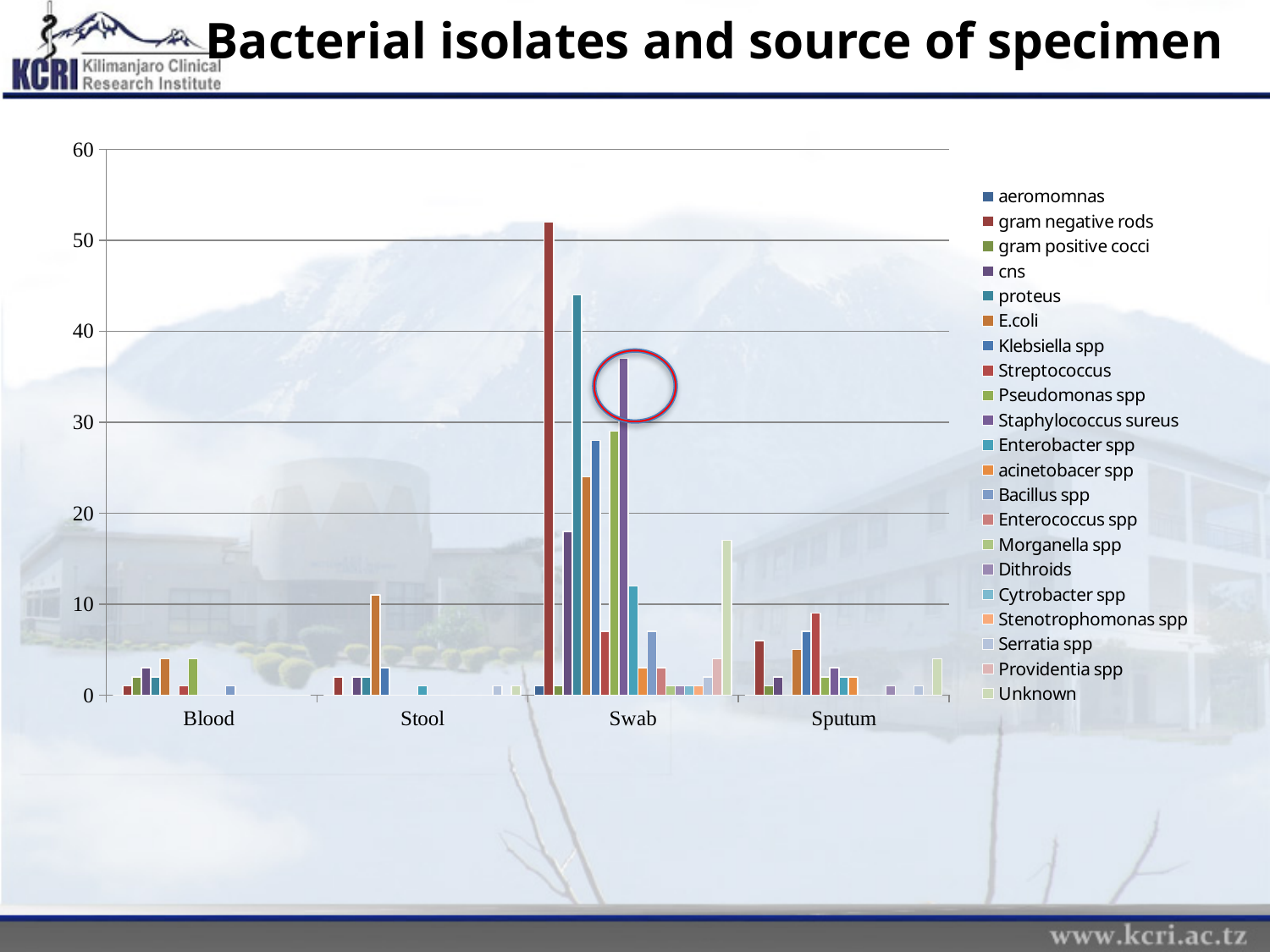
What kind of chart is shown on the slide? bar chart What is the title of the slide containing the chart? Bacterial isolates and source of specimen Is the value for Klebsiella spp in the Swab category greater or less than 30? less Which series is listed first in the legend? aeromomnas Is the value for gram negative rods in the Swab category greater or less than 50? greater Is the value for proteus in the Swab category greater or less than 40? greater Which specimen source category contains the tallest bar in the chart? Swab How many specimen source categories are shown on the x axis? 4 In the Swab category, which is larger: gram negative rods or proteus? gram negative rods How many series does the legend list? 21